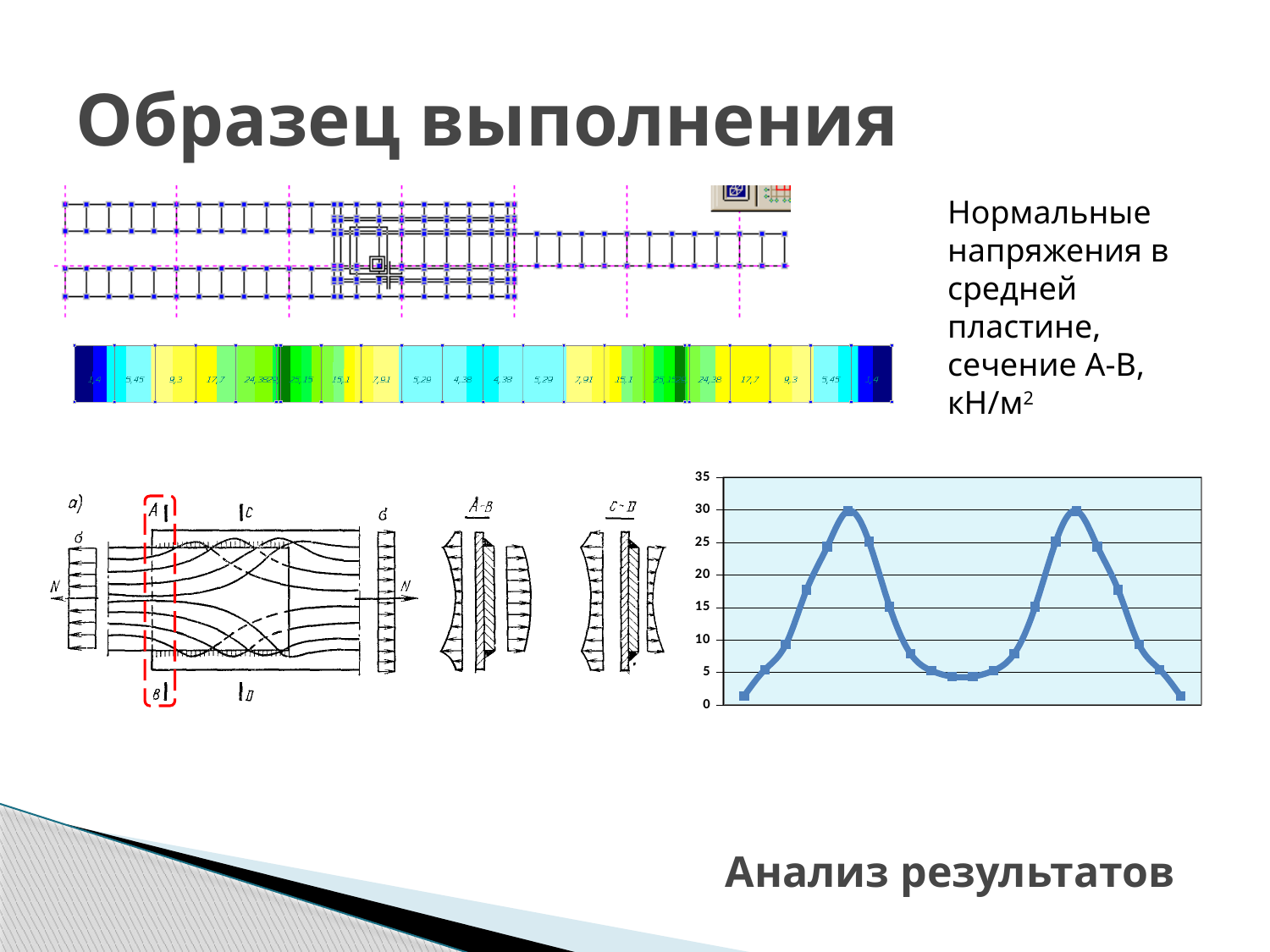
On the line chart at the bottom right, does the line rise or fall between its first point and the first peak? rise On the line chart at the bottom right, what is the step between consecutive tick labels on the vertical axis? 5 On the line chart at the bottom right, is the value at the first peak greater or less than 25? greater On the line chart at the bottom right, is the value at the second peak greater or less than 35? less On the line chart at the bottom right, how many peaks does the line have? 2 On the line chart at the bottom right, is the last point of the line greater or less than 10? less On the line chart at the bottom right, what is the highest value shown on the vertical axis? 35 On the line chart at the bottom right, which is larger: the value at the first peak or the value at the middle dip between the peaks? the first peak What kind of chart is shown at the bottom right of the slide? line chart On the line chart at the bottom right, does the line rise or fall after the second peak? fall